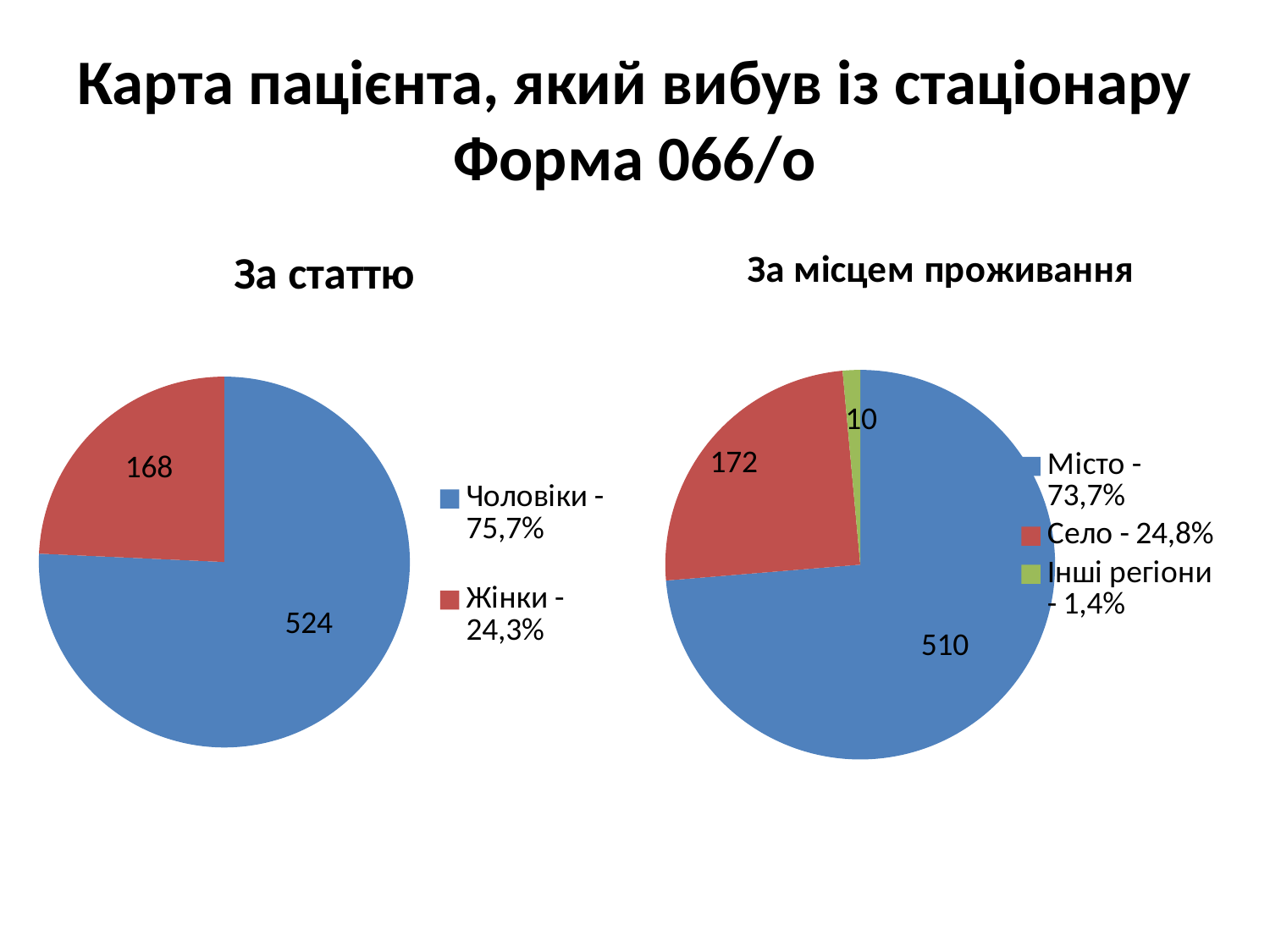
In the 'За статтю' chart, which category has the largest slice? Чоловіки In the 'За місцем проживання' chart, what is the value for Інші регіони? 10 In the 'За статтю' chart, what is the difference between the values for Чоловіки and Жінки? 356 In the 'За статтю' chart, what is the value for Чоловіки? 524 What type of chart is the 'За статтю' chart? Pie chart In the 'За статтю' chart, what share of the pie does Жінки represent according to the legend? 24,3% In the 'За місцем проживання' chart, what is the difference between the values for Місто and Село? 338 In the 'За місцем проживання' chart, which category has the smallest slice? Інші регіони In the 'За місцем проживання' chart, what share of the pie does Місто represent according to the legend? 73,7% In the 'За статтю' chart, what is the value for Жінки? 168 In the 'За місцем проживання' chart, what is the value for Село? 172 In the 'За місцем проживання' chart, how many categories are shown? 3